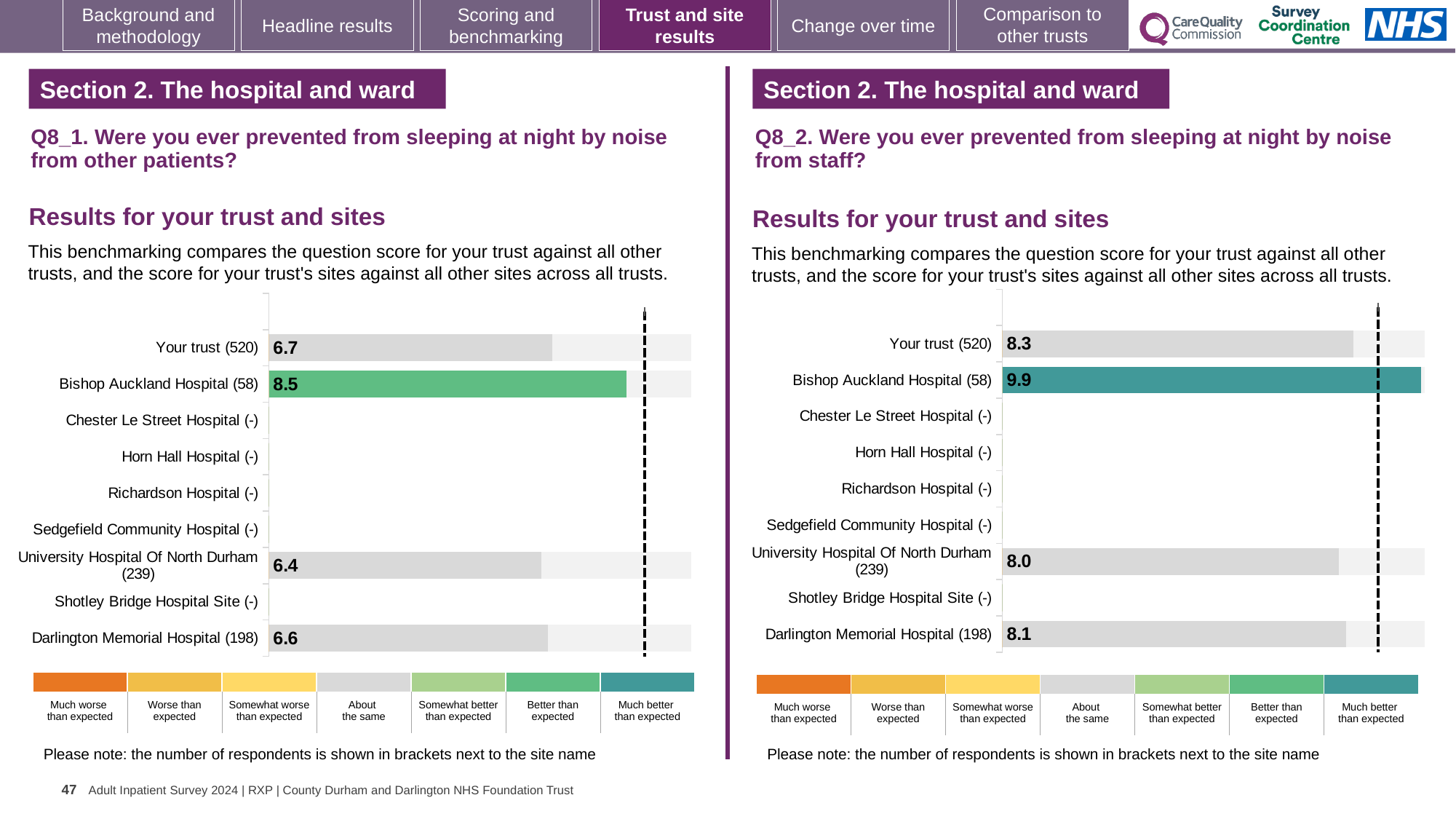
On the Q8_2 chart (right), which benchmark category does the colour of the Bishop Auckland Hospital (58) bar correspond to in the legend? Much better than expected What kind of chart is used on the Q8_1 chart (left)? Bar chart On the Q8_1 chart (left), what is the score for Your trust (520)? 6.7 On the Q8_1 chart (left), what is the score for Bishop Auckland Hospital (58)? 8.5 On the Q8_1 chart (left), which site has the highest score? Bishop Auckland Hospital (58) On the Q8_1 chart (left), which is larger: the score for Your trust (520) or the score for Darlington Memorial Hospital (198)? Your trust (520) On the Q8_1 chart (left), which site with a plotted score has the lowest score? University Hospital Of North Durham (239) On the Q8_2 chart (right), which site has the highest score? Bishop Auckland Hospital (58) On the Q8_2 chart (right), how many sites have a plotted score bar? 3 On the Q8_2 chart (right), what is the score for University Hospital Of North Durham (239)? 8.0 On the Q8_2 chart (right), what is the score for Darlington Memorial Hospital (198)? 8.1 On the Q8_2 chart (right), what is the difference between the score for Bishop Auckland Hospital (58) and the score for Your trust (520)? 1.6